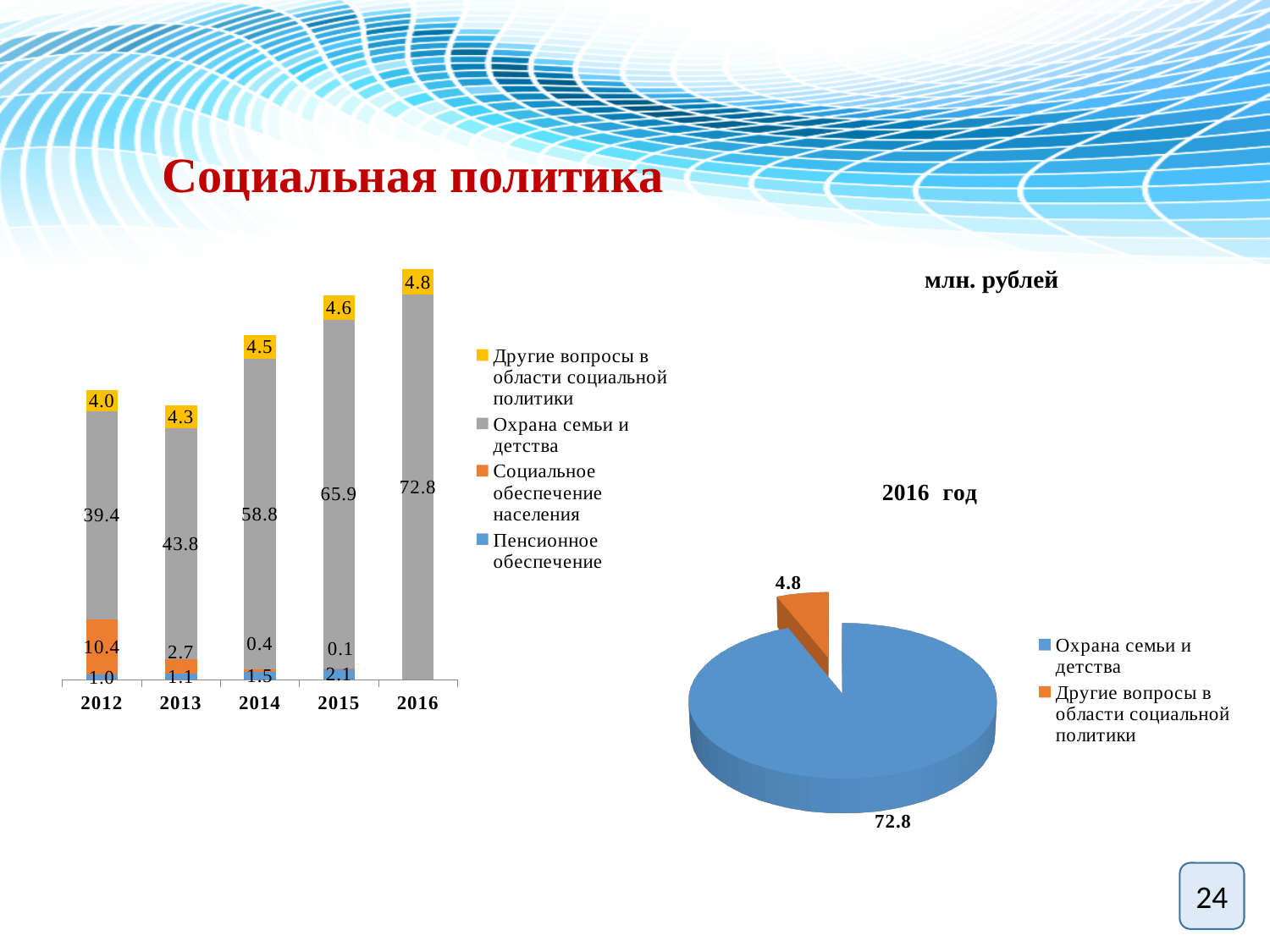
In the stacked bar chart on the left, what is the value for Пенсионное обеспечение in 2015? 2.1 What kind of chart is the chart on the right titled 2016 год? Pie chart How many years are shown on the x axis of the stacked bar chart on the left? 5 In the stacked bar chart on the left, what is the total of the 2012 bar? 54.8 In the stacked bar chart on the left, which is larger: Социальное обеспечение населения in 2013 or in 2014? 2013 In the stacked bar chart on the left, what is the value for Социальное обеспечение населения in 2012? 10.4 How many series does the legend of the stacked bar chart on the left list? 4 In the pie chart on the right, what is the value for Другие вопросы в области социальной политики? 4.8 In the stacked bar chart on the left, what is the value for Охрана семьи и детства in 2014? 58.8 In the stacked bar chart on the left, which year has the highest value for Охрана семьи и детства? 2016 In the stacked bar chart on the left, which year has the lowest value for Другие вопросы в области социальной политики? 2012 In the stacked bar chart on the left, what is the difference between the Охрана семьи и детства values for 2016 and 2015? 6.9